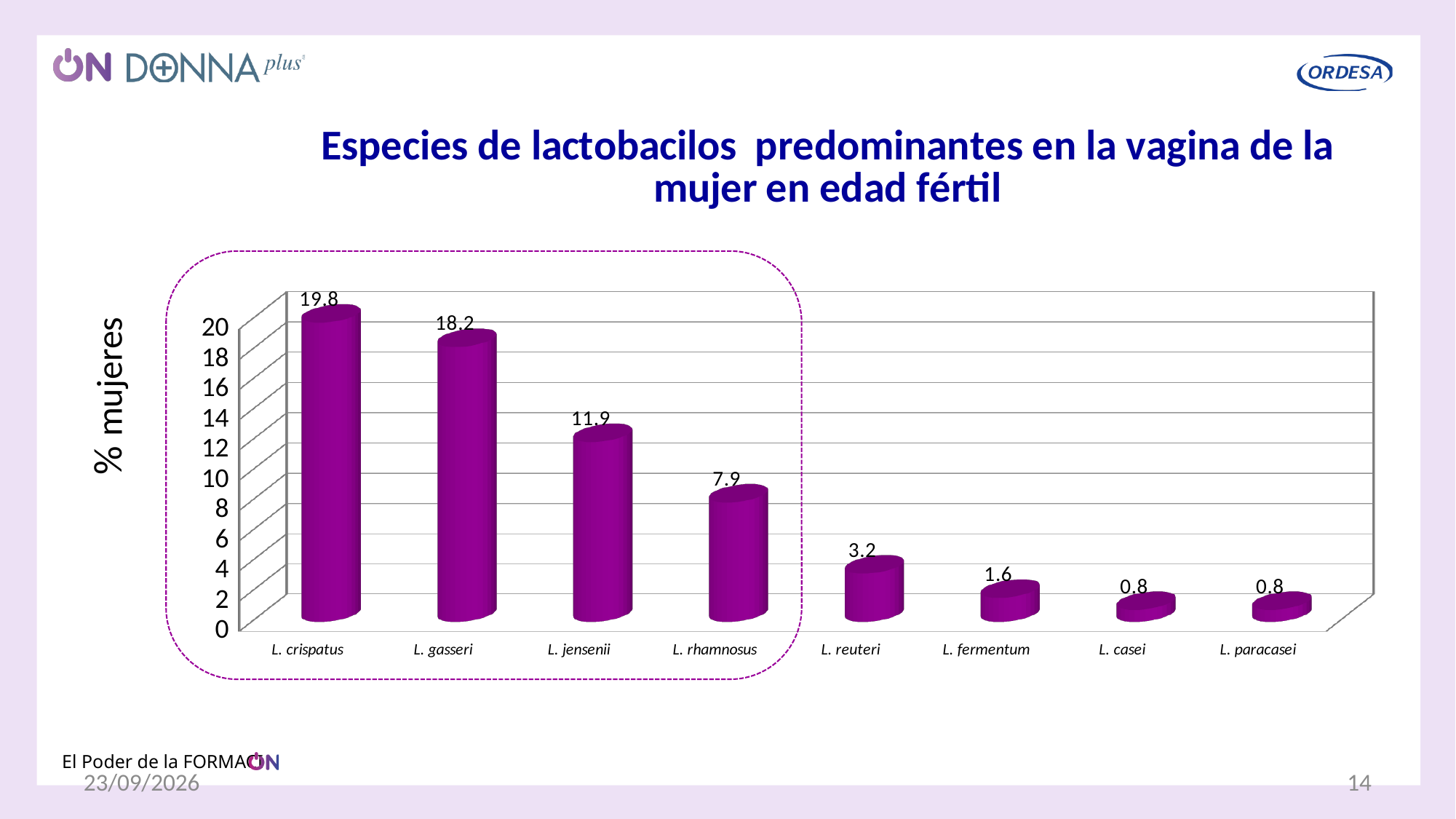
Is the value for L. gasseri greater or less than 16? greater What is the difference between the values for L. jensenii and L. rhamnosus? 4.0 What is the difference between the values for L. crispatus and L. gasseri? 1.6 Which is larger, the value for L. rhamnosus or the value for L. reuteri? L. rhamnosus Which species has the lowest value? L. casei and L. paracasei What is the value for L. reuteri? 3.2 Which species has the highest value? L. crispatus What is the value for L. jensenii? 11.9 What is the value for L. crispatus? 19.8 What is the label of the vertical axis? % mujeres What kind of chart is shown on the slide? bar chart How many species are shown on the x axis? 8